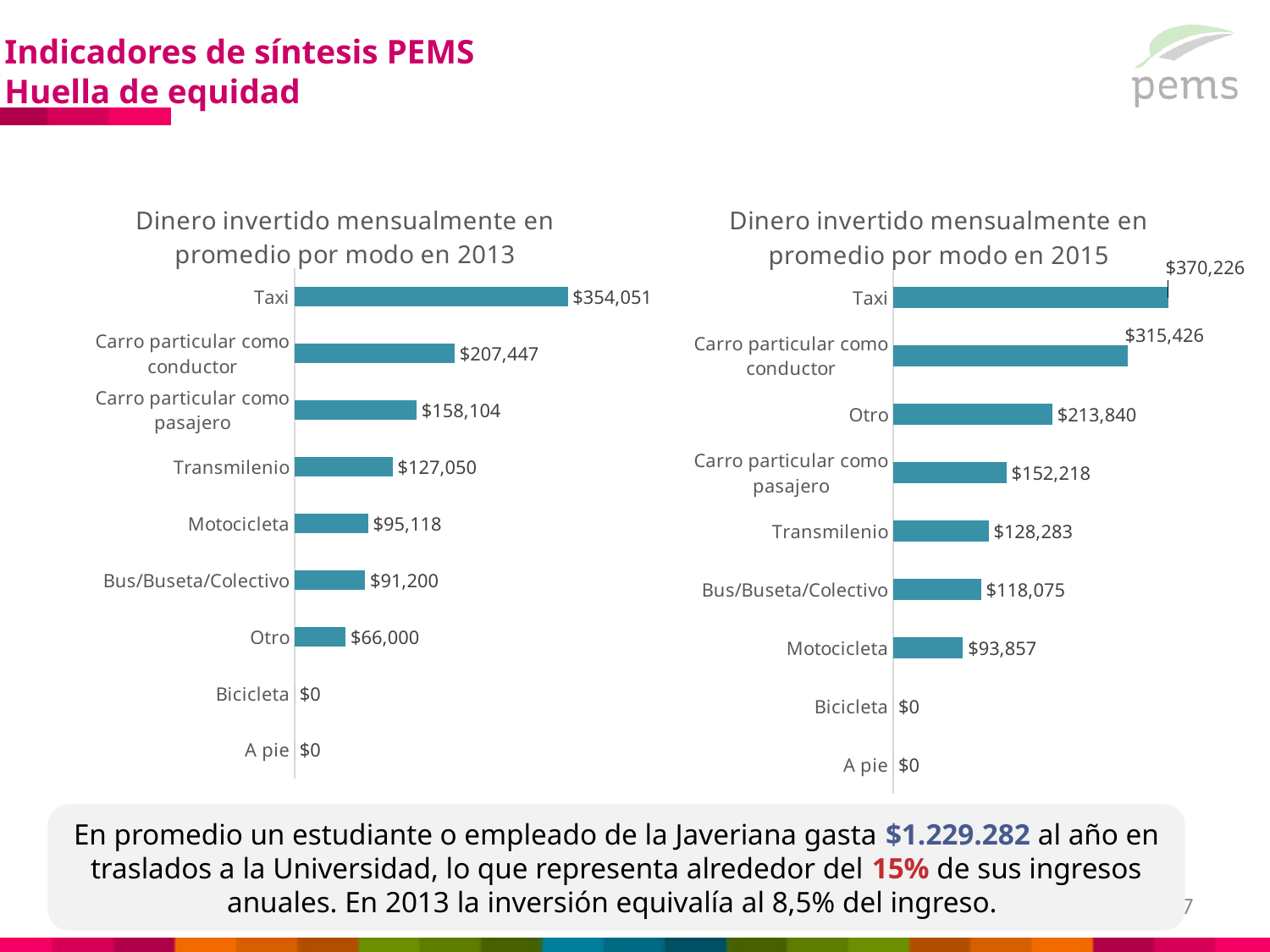
In the chart 'Dinero invertido mensualmente en promedio por modo en 2015', which mode has the highest value? Taxi In the chart 'Dinero invertido mensualmente en promedio por modo en 2015', what is the difference between Taxi and Carro particular como conductor? $54,800 In the chart 'Dinero invertido mensualmente en promedio por modo en 2013', which is larger, Motocicleta or Bus/Buseta/Colectivo? Motocicleta In the chart 'Dinero invertido mensualmente en promedio por modo en 2015', what is the value for Otro? $213,840 In the chart 'Dinero invertido mensualmente en promedio por modo en 2015', what is the value for Bus/Buseta/Colectivo? $118,075 In the chart 'Dinero invertido mensualmente en promedio por modo en 2013', what is the value for Taxi? $354,051 What type of chart is 'Dinero invertido mensualmente en promedio por modo en 2015'? Bar chart Comparing the two charts, how much higher is the Taxi value in 2015 than in 2013? $16,175 How many modes (categories) are shown in the chart 'Dinero invertido mensualmente en promedio por modo en 2013'? 9 In the chart 'Dinero invertido mensualmente en promedio por modo en 2013', what is the difference between Taxi and Carro particular como conductor? $146,604 In the chart 'Dinero invertido mensualmente en promedio por modo en 2015', which is larger, Otro or Carro particular como pasajero? Otro In the chart 'Dinero invertido mensualmente en promedio por modo en 2013', what is the value for Transmilenio? $127,050